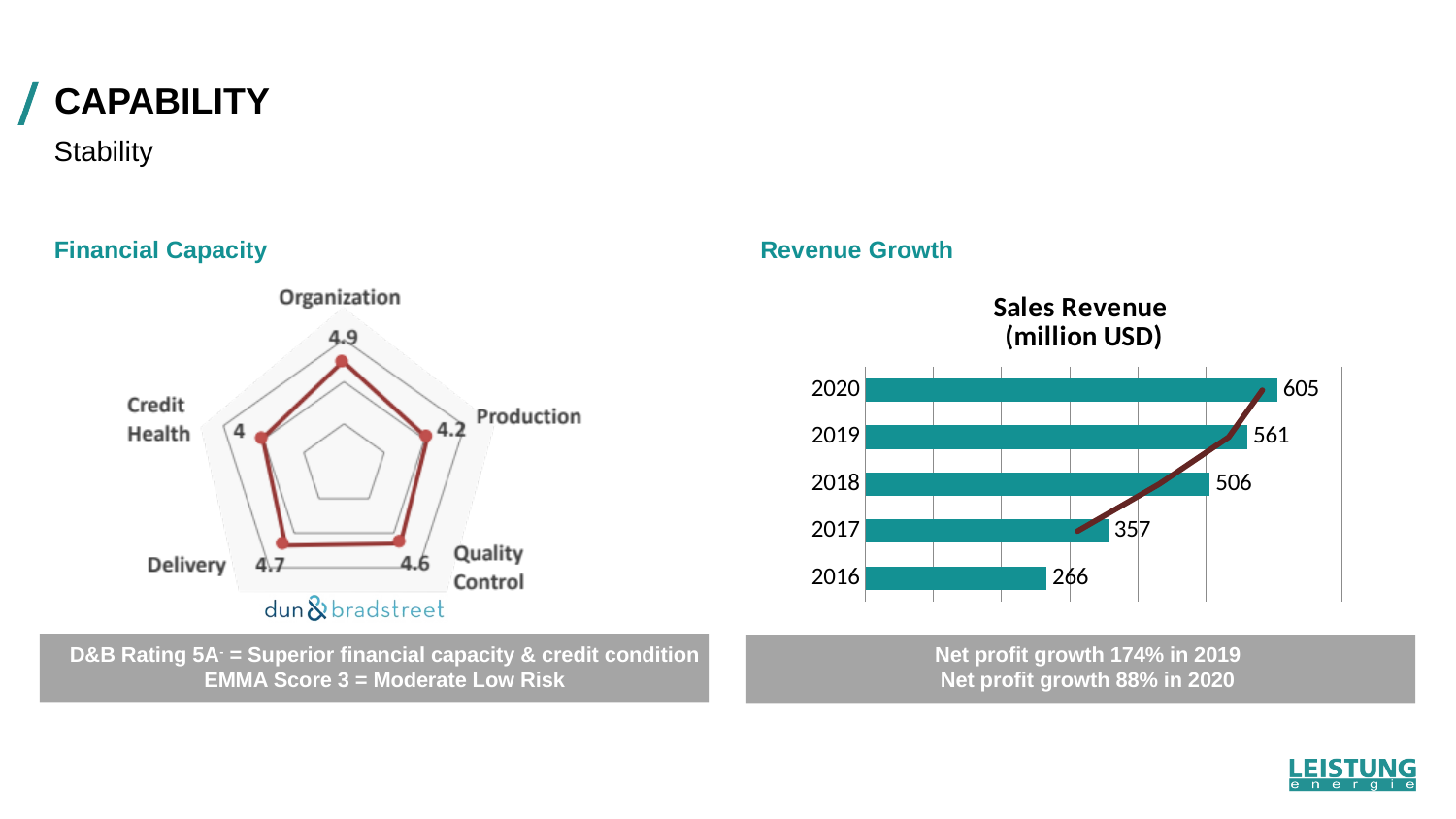
In the Sales Revenue (million USD) chart, what is the difference between the values for 2020 and 2019? 44 In the Sales Revenue (million USD) chart, how many years are shown? 5 What kind of chart is the Sales Revenue (million USD) chart? bar chart In the Sales Revenue (million USD) chart, what is the value for 2018? 506 In the Financial Capacity radar chart, what is the value for Organization? 4.9 In the Sales Revenue (million USD) chart, what is the difference between the values for 2017 and 2016? 91 In the Sales Revenue (million USD) chart, what is the value for 2016? 266 In the Sales Revenue (million USD) chart, which year has the lowest value? 2016 In the Financial Capacity radar chart, which is larger, Delivery or Quality Control? Delivery In the Sales Revenue (million USD) chart, which year has the highest value? 2020 In the Financial Capacity radar chart, which category has the lowest value? Credit Health In the Sales Revenue (million USD) chart, do the values rise or fall from 2016 to 2020? rise